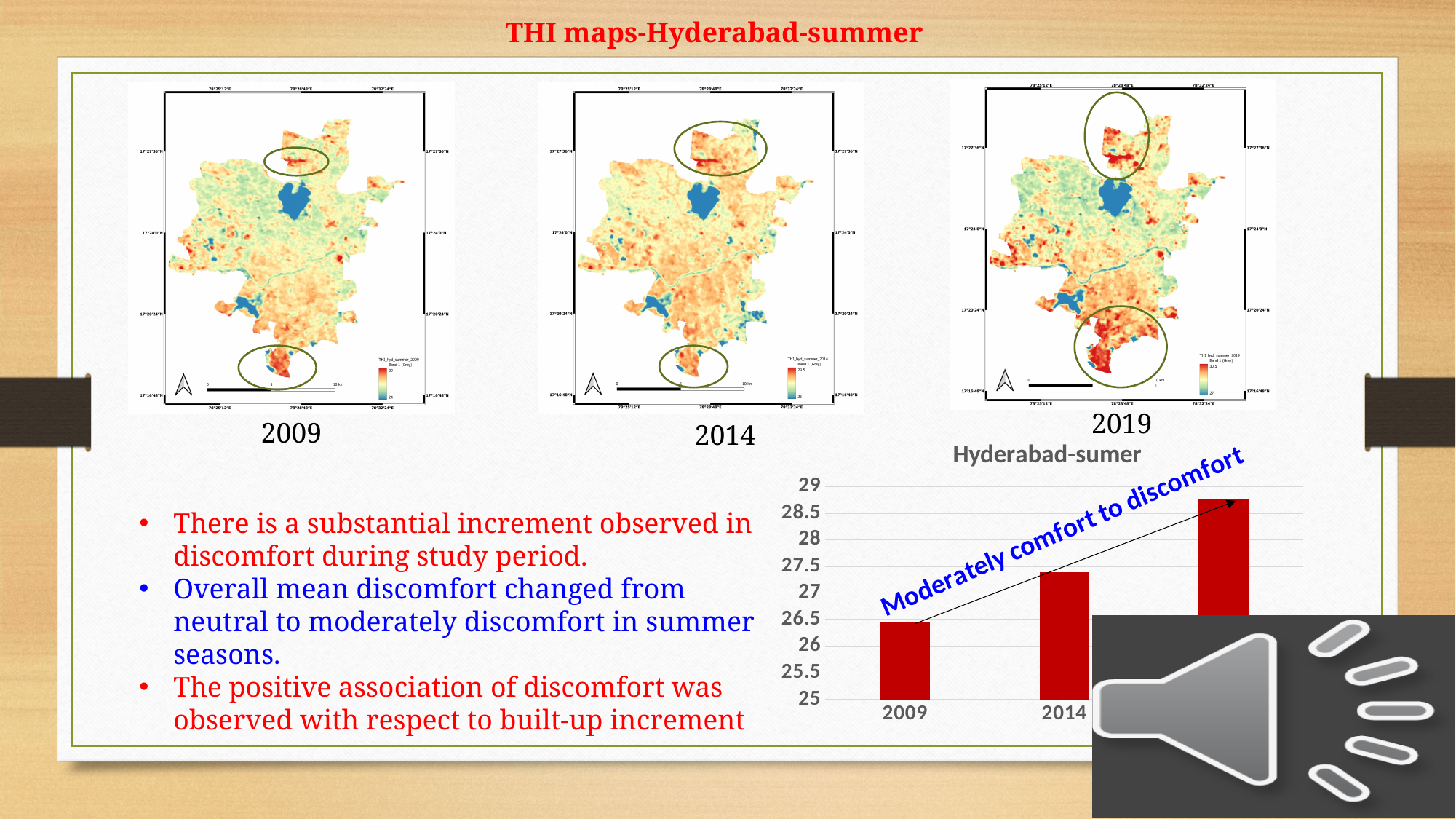
What is the title of the bar chart on the slide? Hyderabad-sumer In the Hyderabad-sumer chart, is the value of the rightmost bar greater or less than 28.5? greater In the Hyderabad-sumer chart, is the value for 2009 greater or less than 27? less In the Hyderabad-sumer chart, which is larger, the value for 2009 or the value for 2014? 2014 In the Hyderabad-sumer chart, is the value for 2014 greater or less than 27? greater How many bars are plotted in the Hyderabad-sumer chart? 3 In the Hyderabad-sumer chart, do the values rise or fall from left to right along the x axis? rise In the Hyderabad-sumer chart, which year has the lowest value? 2009 What text is written along the arrow annotation on the Hyderabad-sumer chart? Moderately comfort to discomfort What kind of chart is the Hyderabad-sumer chart? bar chart